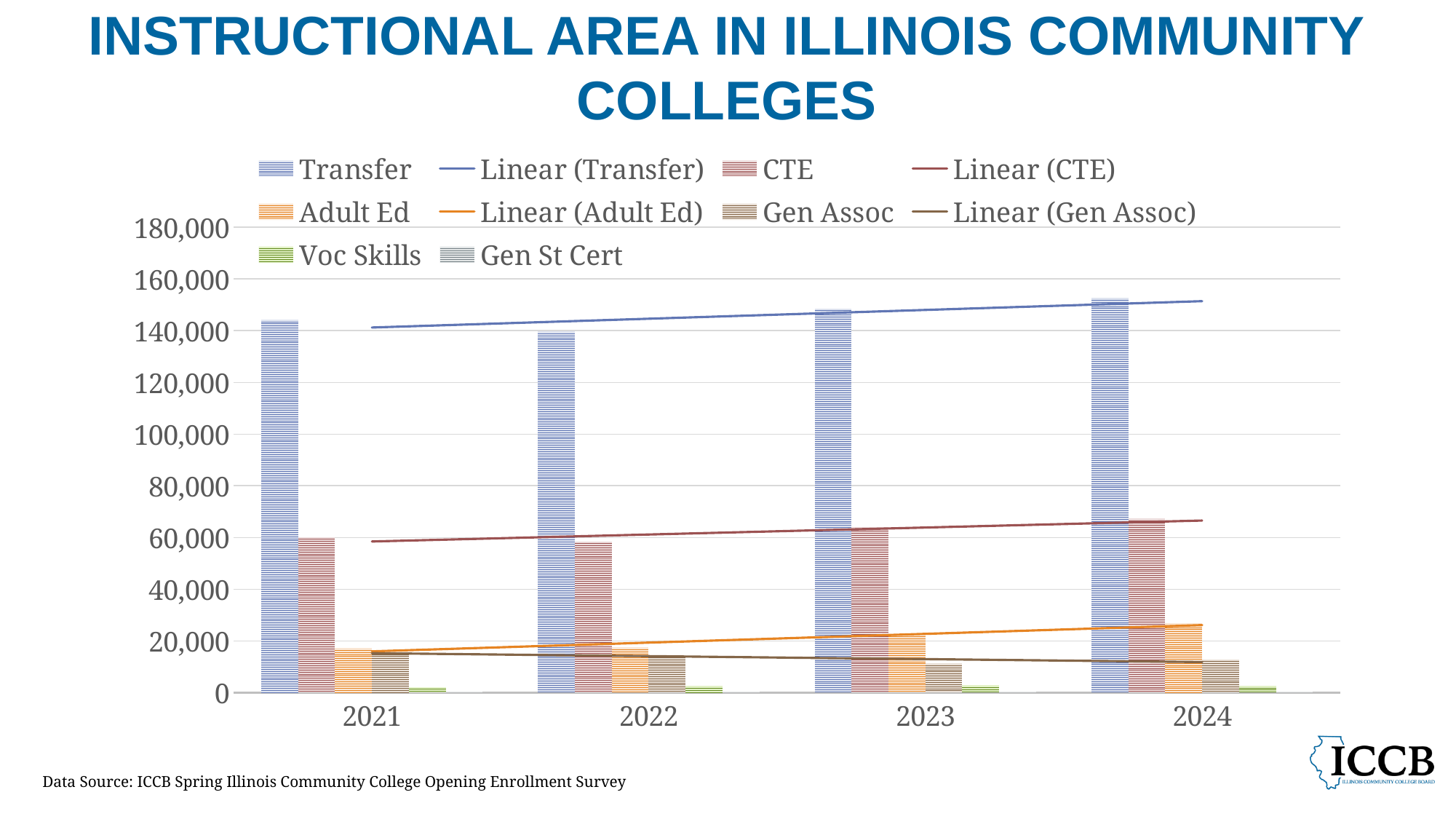
Is the value for CTE in 2024 greater or less than 60,000? greater In which year is the Transfer bar the highest? 2024 Which is larger in 2024, Adult Ed or Gen Assoc? Adult Ed In which year is the CTE bar the highest? 2024 Does the Linear (Transfer) trendline rise or fall from 2021 to 2024? rise Is the value for Adult Ed in 2024 greater or less than 20,000? greater How many years are shown on the x axis of the chart? 4 What data source is cited at the bottom of the slide? ICCB Spring Illinois Community College Opening Enrollment Survey How many entries does the chart's legend list? 10 Is the value for Transfer in 2024 greater or less than 140,000? greater What kind of chart is shown on the slide? bar chart